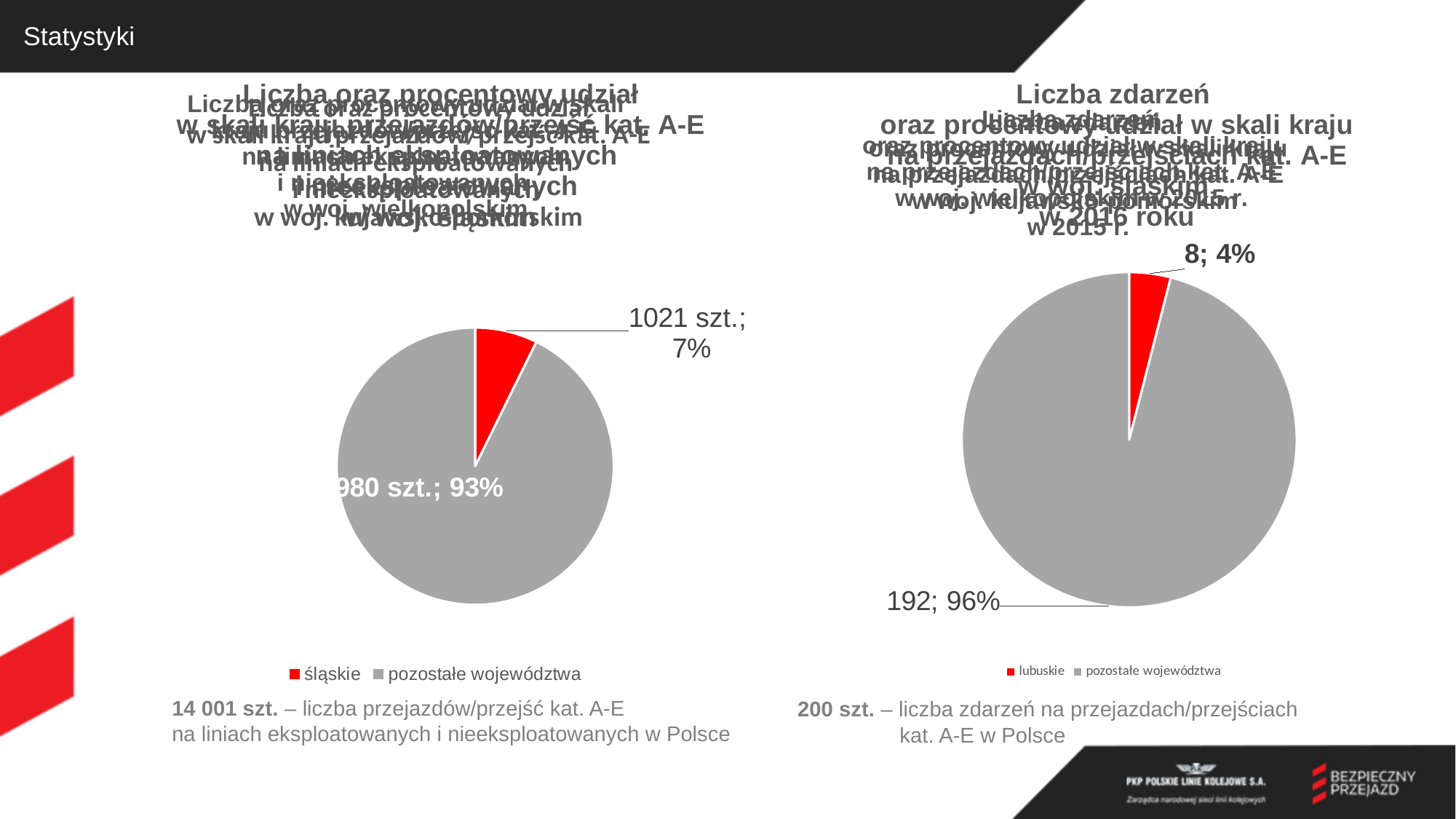
In the left pie chart, what value is shown for śląskie? 1021 szt.; 7% In the left pie chart, what percentage share does śląskie have? 7% How many slices does the right pie chart have? 2 In the right pie chart, what value is shown for lubuskie? 8; 4% In the left pie chart, which slice is the smallest? śląskie In the right pie chart, what value is shown for pozostałe województwa? 192; 96% What type of chart is shown on the left side of the slide? pie chart In the right pie chart, what is the difference between the count for pozostałe województwa and the count for lubuskie? 184 In the right pie chart, what percentage share does lubuskie have? 4% In the left pie chart, what colour is the śląskie slice? red In the right pie chart, which slice is the largest? pozostałe województwa In the left pie chart, what percentage share do pozostałe województwa have? 93%